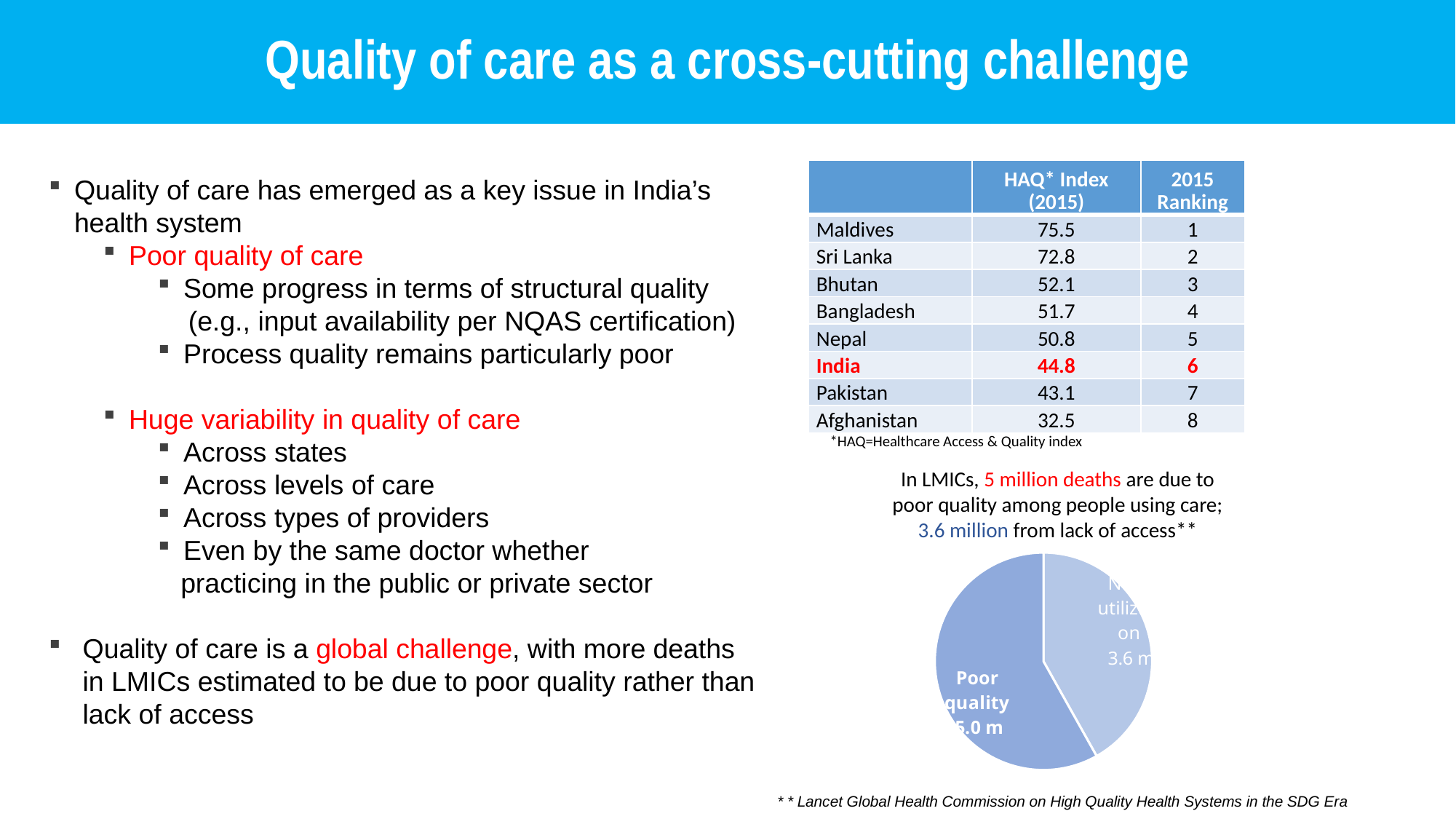
How many slices does the pie chart have? 2 What is the total of the two values shown in the pie chart? 8.6 m Is the Poor quality slice of the pie chart larger or smaller than the other slice? larger What value is shown for the Poor quality slice of the pie chart? 5.0 m What is the difference between the two values shown in the pie chart (5.0 m and 3.6 m)? 1.4 m What value is shown for the smaller slice of the pie chart? 3.6 m Which slice of the pie chart is the largest? Poor quality Which slice of the pie chart is drawn in the darker blue? Poor quality What kind of chart is shown at the bottom right of the slide? pie chart